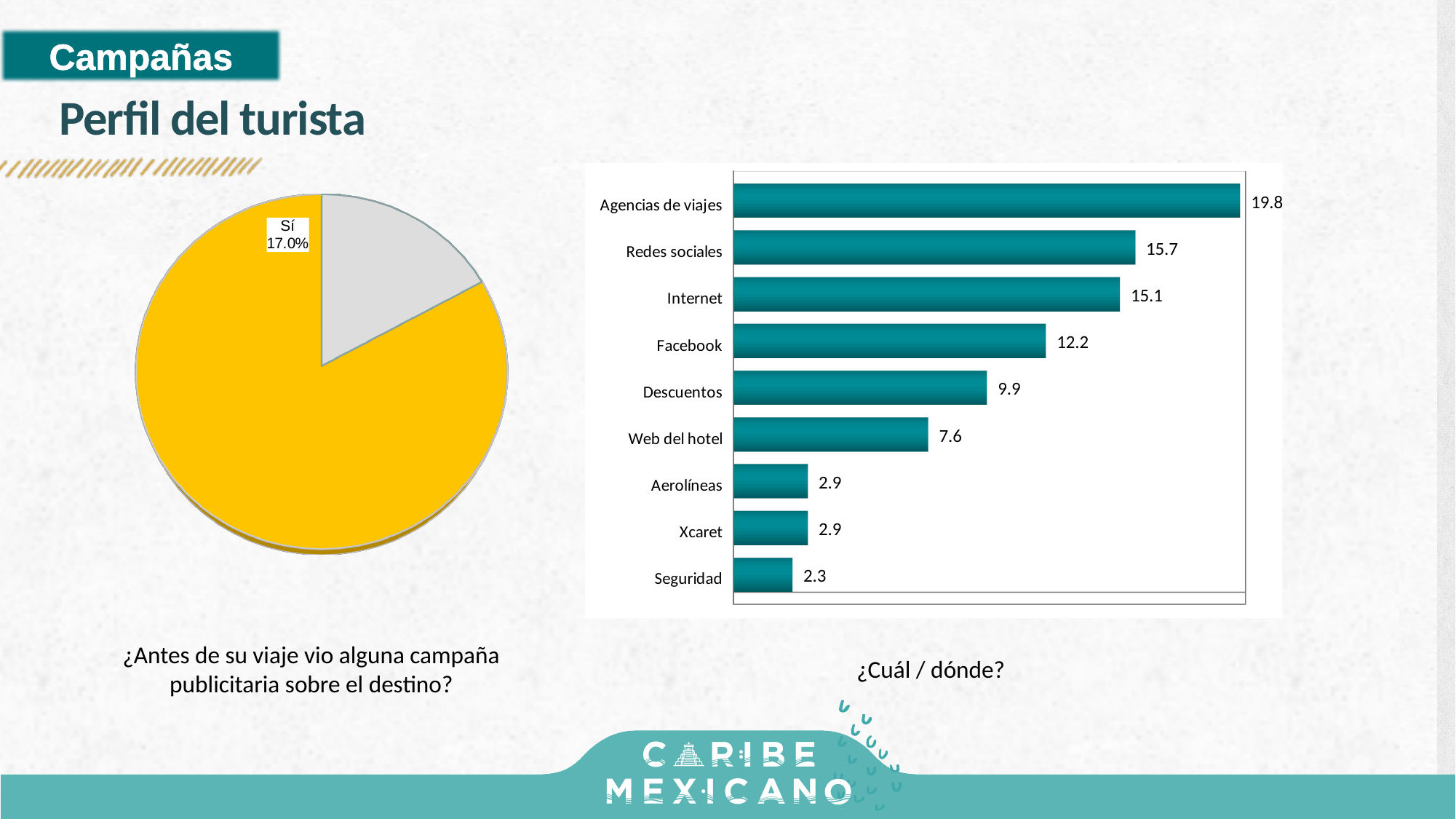
In the bar chart on the right, which category has the highest value? Agencias de viajes What kind of chart is the chart on the right of the slide? Bar chart In the bar chart on the right, what is the difference between the values for Agencias de viajes and Descuentos? 9.9 In the pie chart on the left, what share is labelled for the 'Sí' slice? 17.0% In the bar chart on the right, what is the difference between the values for Redes sociales and Internet? 0.6 In the bar chart on the right, which is larger, the value for Facebook or the value for Descuentos? Facebook In the bar chart on the right, what is the value for Agencias de viajes? 19.8 What kind of chart is the chart on the left of the slide? Pie chart In the bar chart on the right, what is the value for Facebook? 12.2 How many categories are shown in the bar chart on the right? 9 In the bar chart on the right, which category has the lowest value? Seguridad In the bar chart on the right, what is the value for Web del hotel? 7.6